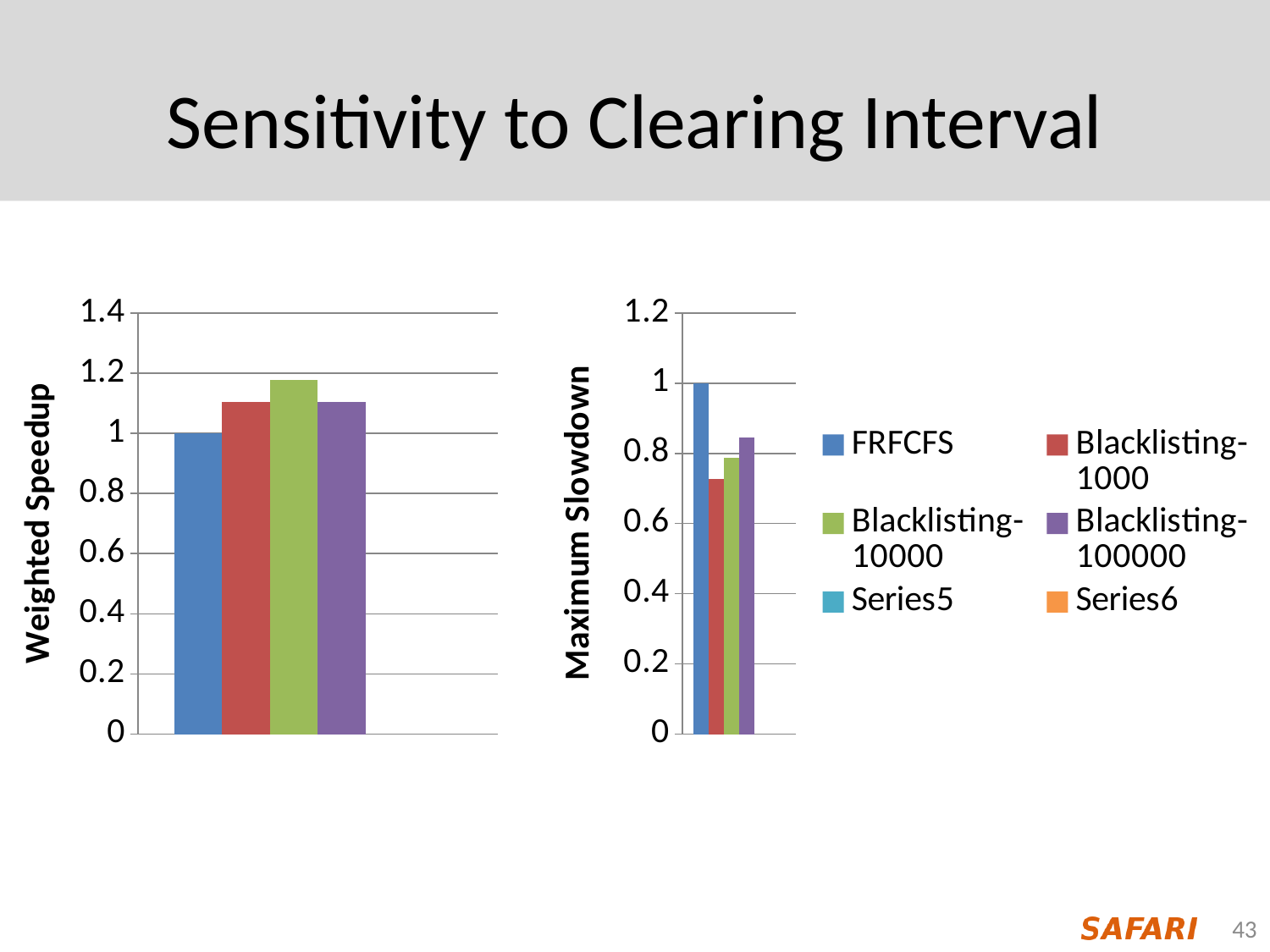
What kind of chart is the Weighted Speedup chart on the left? bar chart In the Maximum Slowdown chart, what is the value for FRFCFS? 1 In the Weighted Speedup chart, what is the value for FRFCFS? 1 In the Weighted Speedup chart, which series has the lowest value? FRFCFS How many series does the legend list? 6 In the Weighted Speedup chart, which series has the highest value? Blacklisting-10000 In the Maximum Slowdown chart, which series has the lowest value? Blacklisting-1000 In the Maximum Slowdown chart, is the value for Blacklisting-1000 greater or less than 0.8? less In the Weighted Speedup chart, is the value for Blacklisting-10000 greater or less than 1.2? less In the Maximum Slowdown chart, which series has the highest value? FRFCFS What is the y-axis label of the chart on the left? Weighted Speedup In the Maximum Slowdown chart, which is larger, Blacklisting-100000 or Blacklisting-1000? Blacklisting-100000